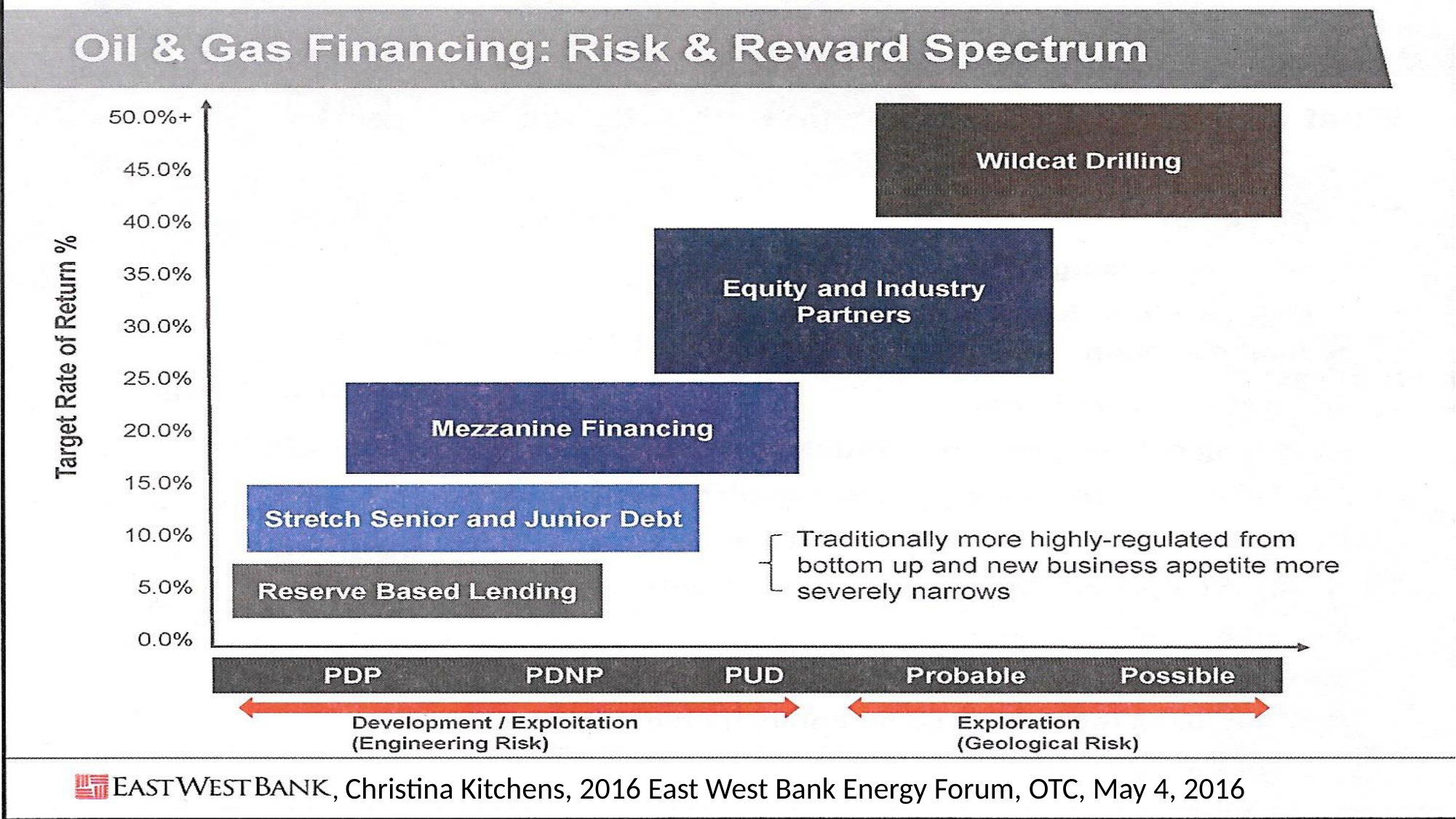
How many reserve categories are listed along the x axis? 5 What is the label of the y axis? Target Rate of Return % Which financing type has the lowest target rate of return on the chart? Reserve Based Lending Is the target rate of return for Stretch Senior and Junior Debt greater or less than 20.0%? less Is the target rate of return for Equity and Industry Partners greater or less than 20.0%? greater Does the target rate of return rise or fall moving along the x axis from PDP to Possible? rise Is the target rate of return for Mezzanine Financing greater or less than 15.0%? greater Which financing type has the highest target rate of return on the chart? Wildcat Drilling How many financing types are shown on the chart? 5 Which has a higher target rate of return, Mezzanine Financing or Stretch Senior and Junior Debt? Mezzanine Financing